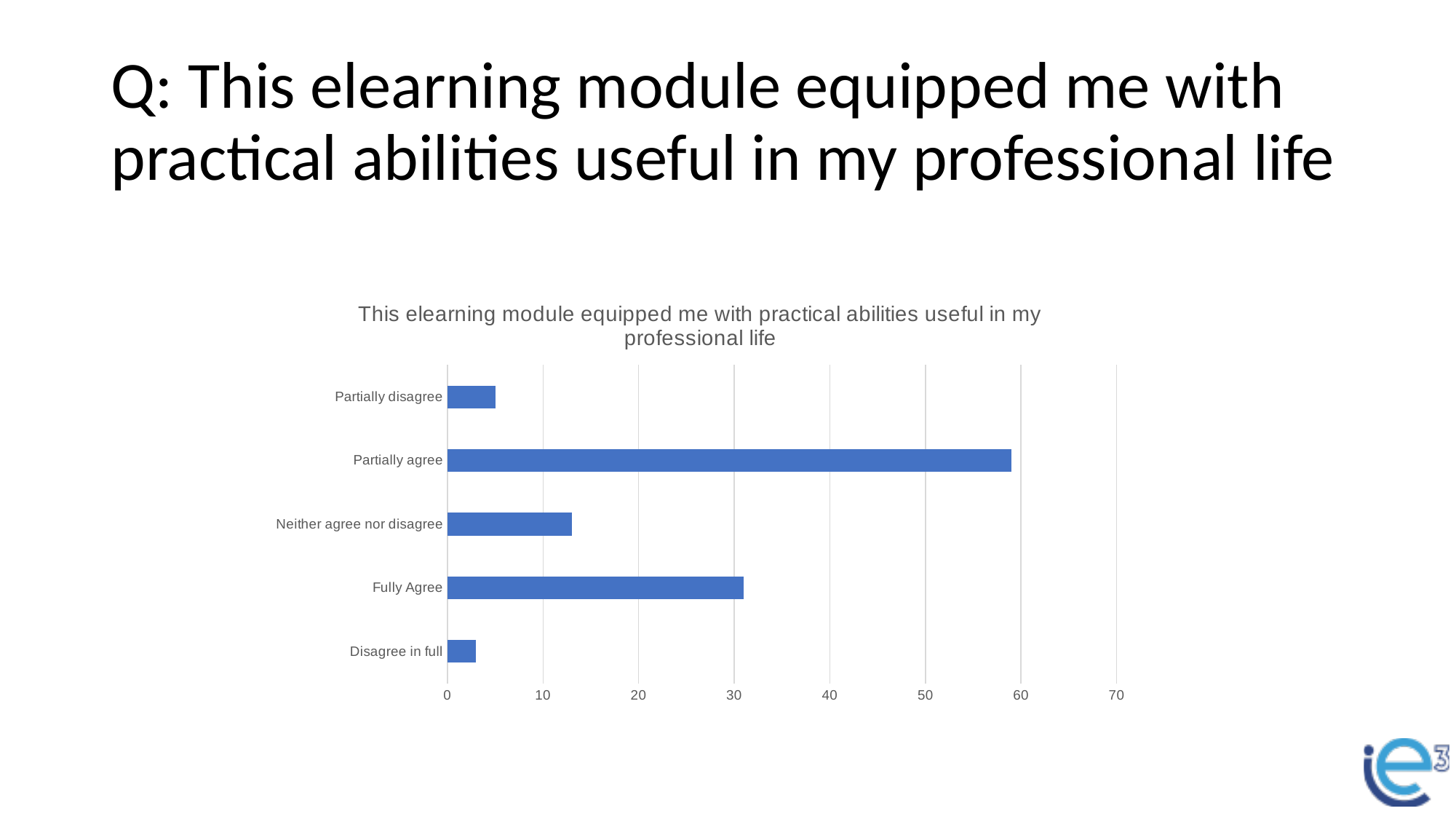
Is the value for Partially disagree greater or less than 10? less Which category has the lowest value? Disagree in full How many categories are plotted in the chart? 5 Which is larger, the value for Partially disagree or the value for Disagree in full? Partially disagree Which category has the highest value? Partially agree Is the value for Disagree in full greater or less than 10? less Is the value for Neither agree nor disagree greater or less than 10? greater Which is larger, the value for Fully Agree or the value for Neither agree nor disagree? Fully Agree What is the highest tick value shown on the horizontal axis? 70 What kind of chart is shown on the slide? bar chart